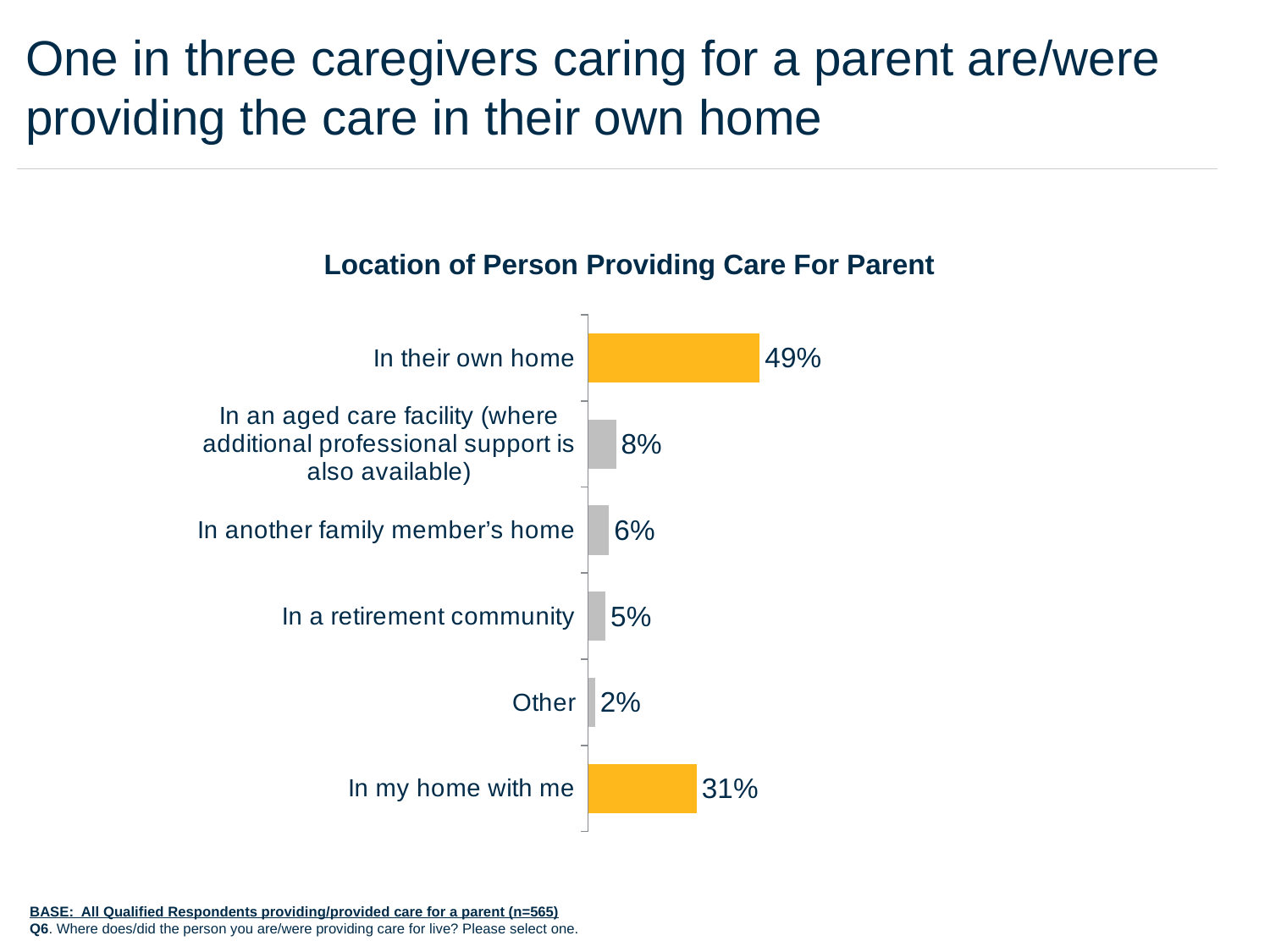
Which is larger: 'In another family member's home' or 'In a retirement community'? In another family member's home What is the value for 'In an aged care facility (where additional professional support is also available)'? 8% Which two categories are highlighted with orange bars? In their own home; In my home with me Which category has the highest value? In their own home What is the value for 'In my home with me'? 31% What is the value for 'In a retirement community'? 5% Which category has the lowest value? Other What percentage of caregivers provided care in their own home (the parent's own home)? 49% How many categories are shown in the chart? 6 What kind of chart is shown on the slide? Bar chart What is the title of the chart? Location of Person Providing Care For Parent What is the difference between 'In their own home' and 'In my home with me'? 18%